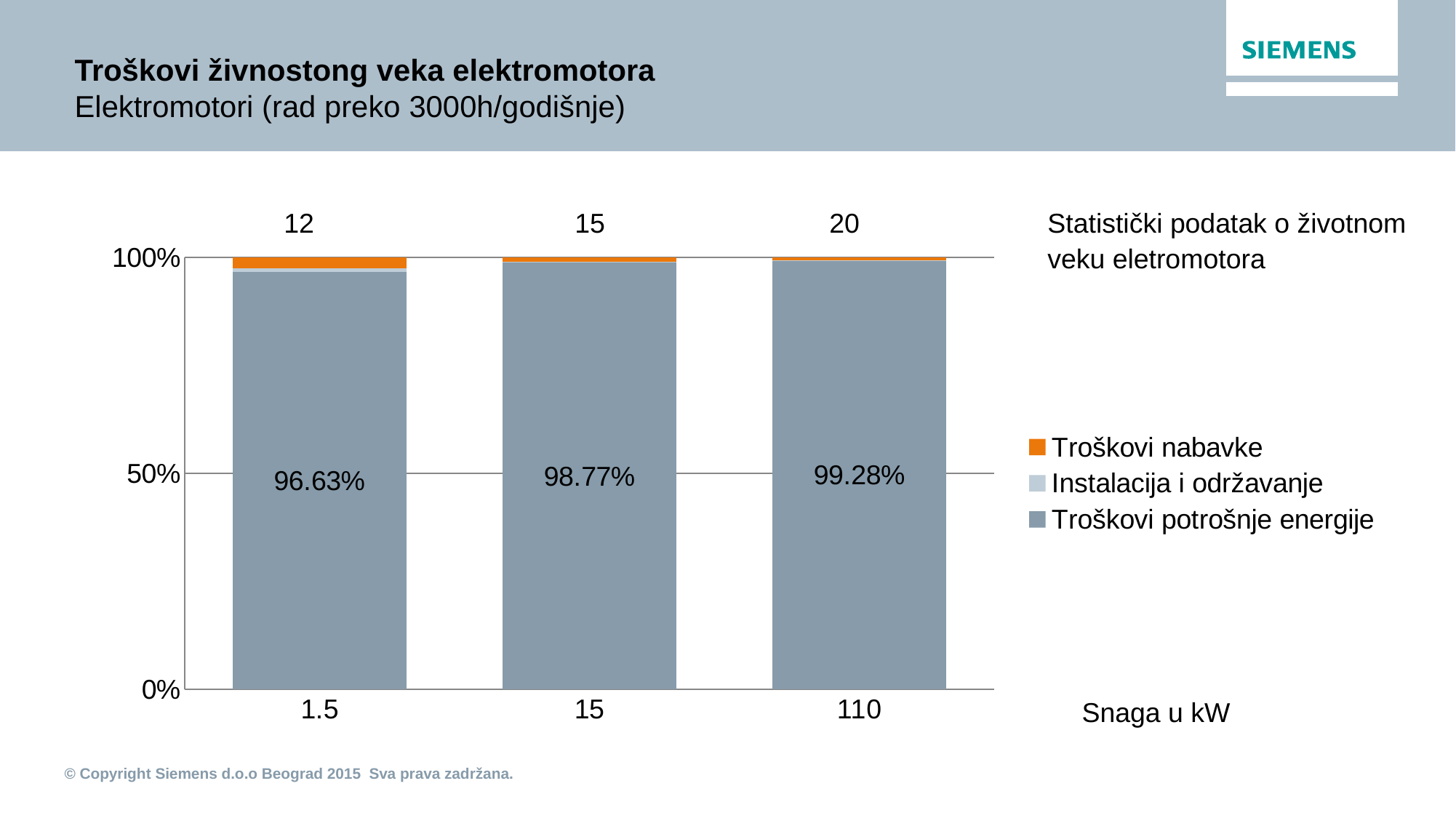
What is the value of Troškovi potrošnje energije for the 110 kW category? 99.28% What is the difference between the Troškovi potrošnje energije values for 110 kW and 1.5 kW? 2.65% Which category has the lowest value for Troškovi potrošnje energije? 1.5 Which category has the highest value for Troškovi potrošnje energije? 110 What kind of chart is shown on the slide? stacked bar chart Is the Troškovi potrošnje energije value for 1.5 kW greater or less than 50%? greater What is the value of Troškovi potrošnje energije for the 15 kW category? 98.77% Do the Troškovi potrošnje energije values rise or fall from left to right along the x axis? rise What is the value of Troškovi potrošnje energije for the 1.5 kW category? 96.63% Which is larger, the Troškovi potrošnje energije value for 15 kW or for 1.5 kW? 15 kW How many categories are shown on the x axis? 3 How many series does the legend list? 3